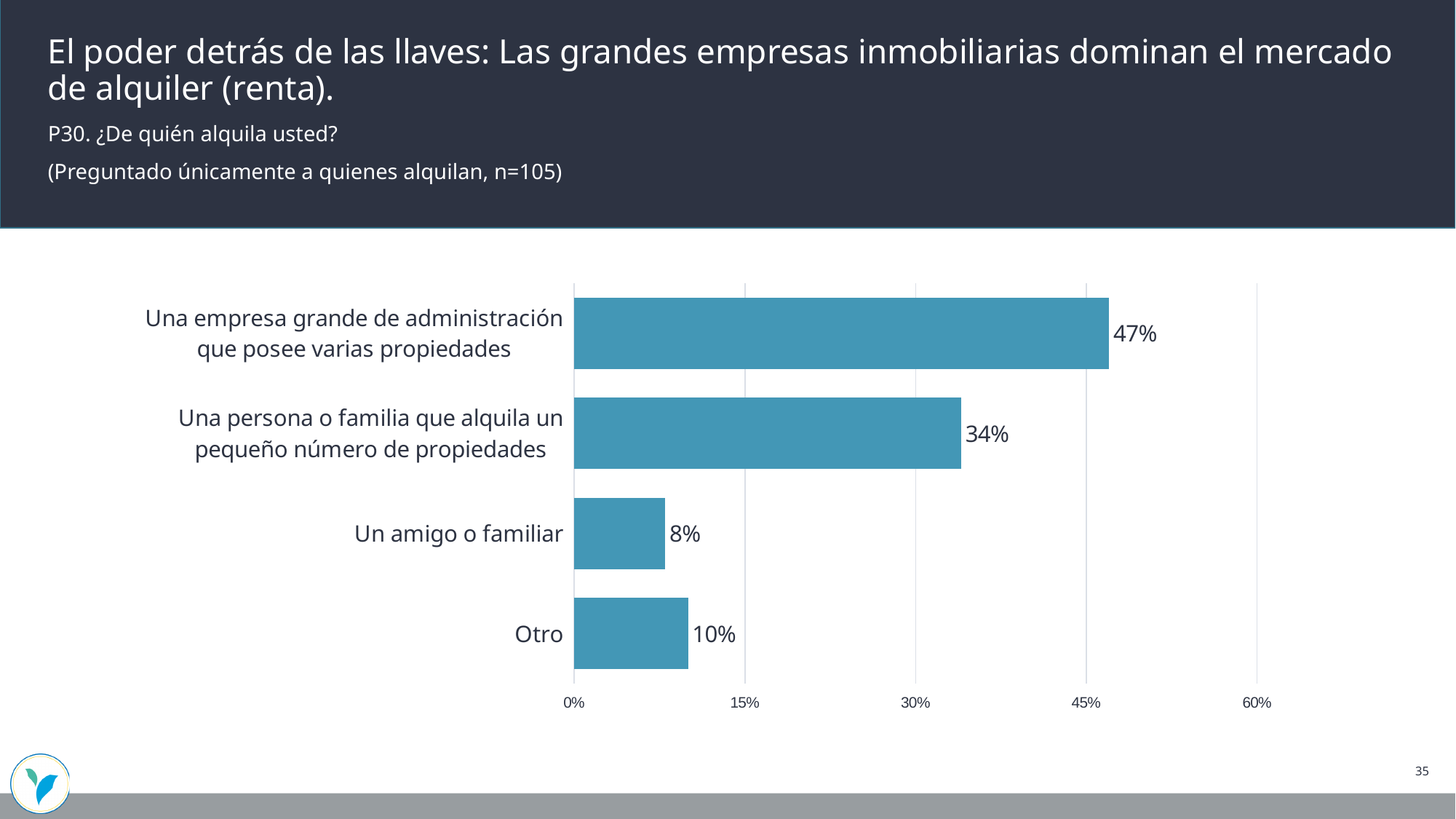
Which category has the lowest value? Un amigo o familiar Is the value for 'Una persona o familia que alquila un pequeño número de propiedades' greater or less than 30%? greater What is the value for 'Una persona o familia que alquila un pequeño número de propiedades'? 34% Which category has the highest value? Una empresa grande de administración que posee varias propiedades What kind of chart is shown on the slide? Bar chart What is the difference between the value for 'Una empresa grande de administración que posee varias propiedades' and 'Una persona o familia que alquila un pequeño número de propiedades'? 13% What percentage of renters rent from a large management company that owns several properties (Una empresa grande de administración que posee varias propiedades)? 47% Which is larger, the value for 'Otro' or the value for 'Un amigo o familiar'? Otro How many categories are shown in the chart? 4 What is the value for 'Un amigo o familiar'? 8% What is the sample size (n) stated for the question shown on the slide? n=105 What is the value for 'Otro'? 10%